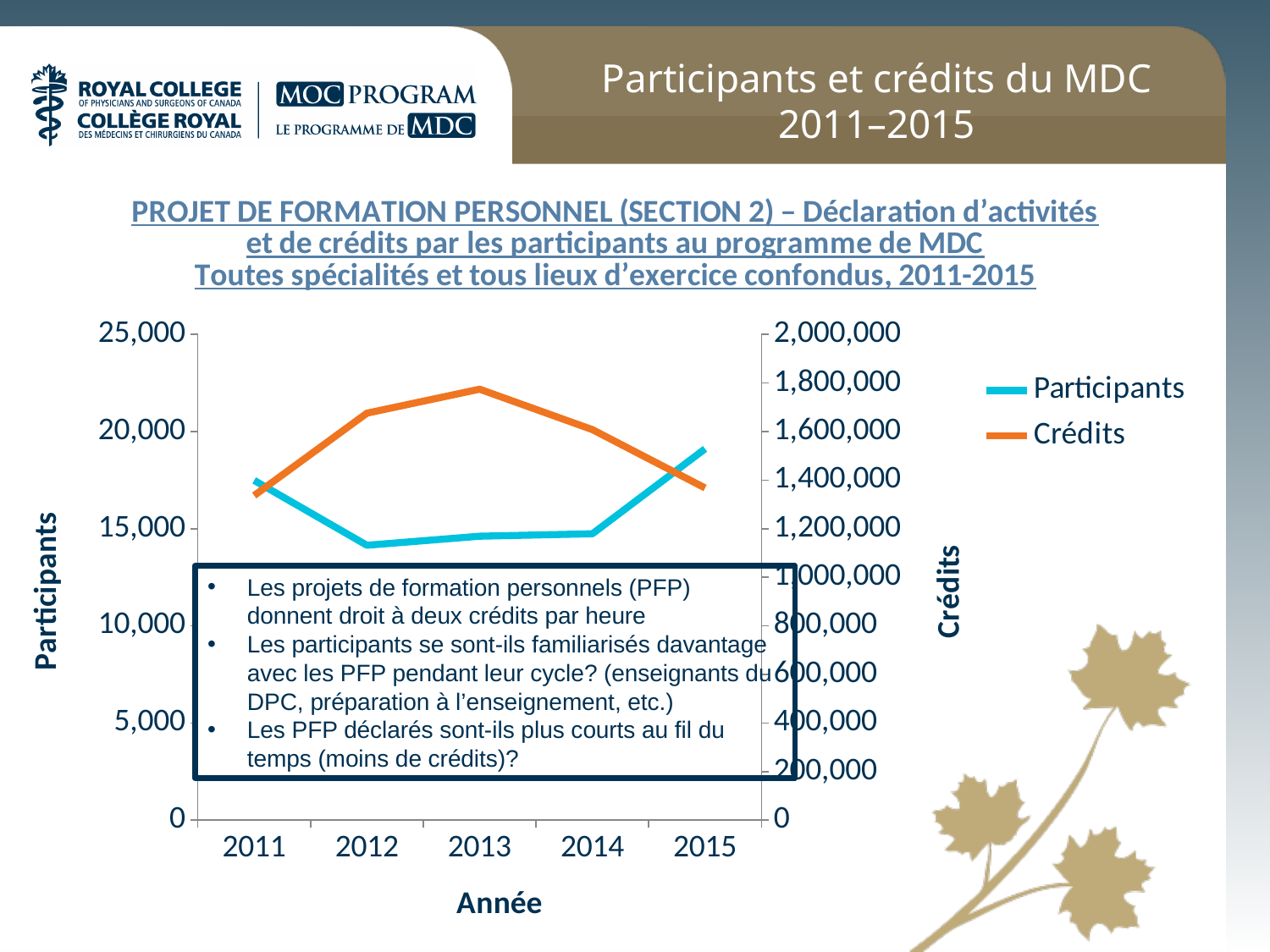
In which year is the Participants series at its highest? 2015 Is the value for Crédits in 2013 greater or less than 1,600,000? greater What kind of chart is shown on the slide? line chart What is the title of the x axis of the chart? Année How many years are plotted along the x axis of the chart? 5 Is the value for Participants in 2012 greater or less than 15,000? less In which year is the Crédits series at its highest? 2013 Does the Crédits series rise or fall from 2013 to 2015? fall Is the value for Participants in 2015 greater or less than 15,000? greater Which year has more Participants, 2012 or 2015? 2015 How many series does the chart legend list? 2